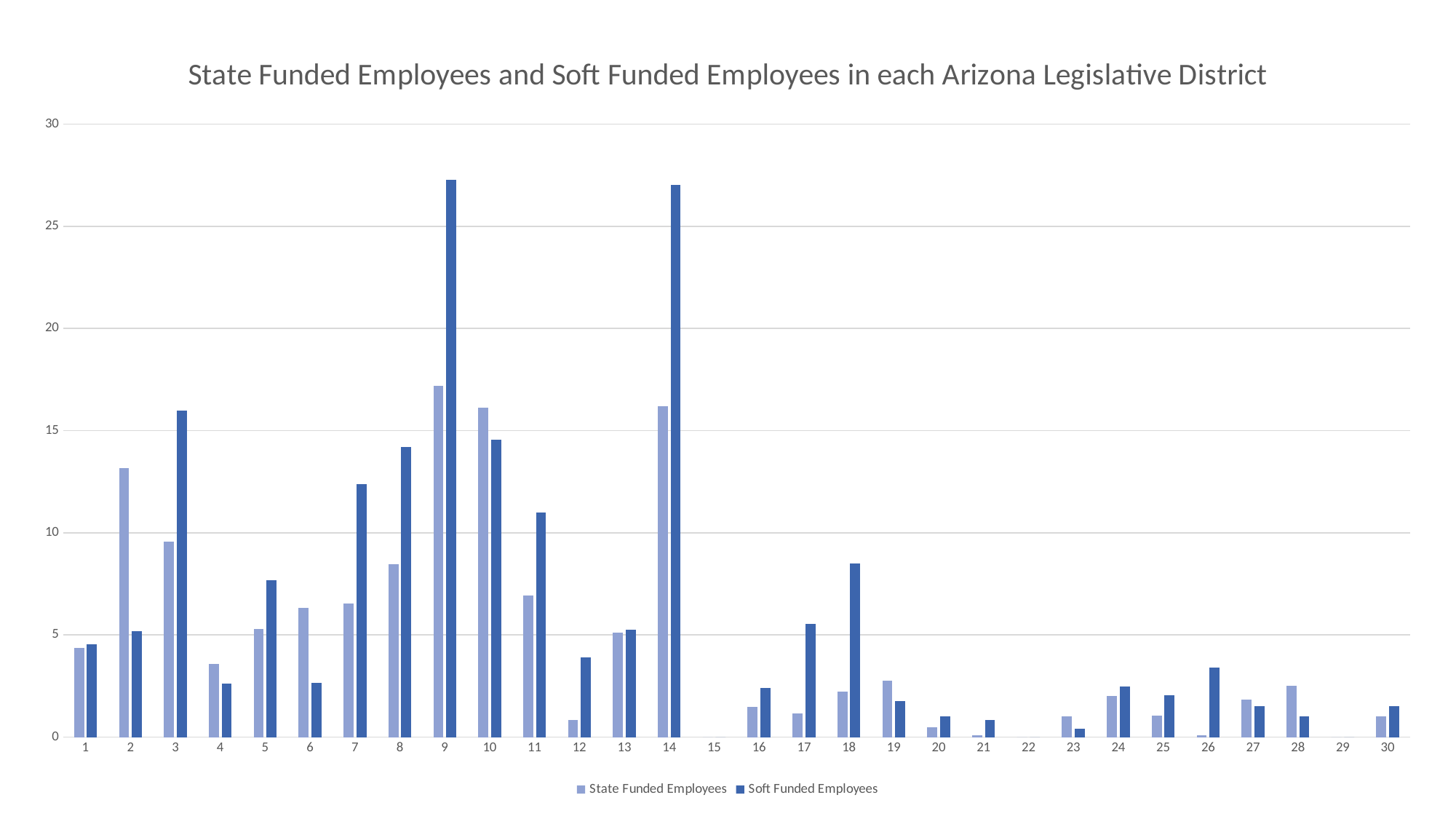
What is the title of the chart? State Funded Employees and Soft Funded Employees in each Arizona Legislative District Is the value for Soft Funded Employees in district 7 greater or less than 10? greater In district 3, which series has the larger value, State Funded Employees or Soft Funded Employees? Soft Funded Employees Is the value for State Funded Employees in district 12 greater or less than 5? less Is the value for Soft Funded Employees in district 18 greater or less than 5? greater What kind of chart is shown on the slide? bar chart How many legislative districts are shown on the x axis? 30 In district 2, which series has the larger value, State Funded Employees or Soft Funded Employees? State Funded Employees How many series does the legend list? 2 Which district has the highest value for State Funded Employees? 9 In district 6, which series has the larger value, State Funded Employees or Soft Funded Employees? State Funded Employees